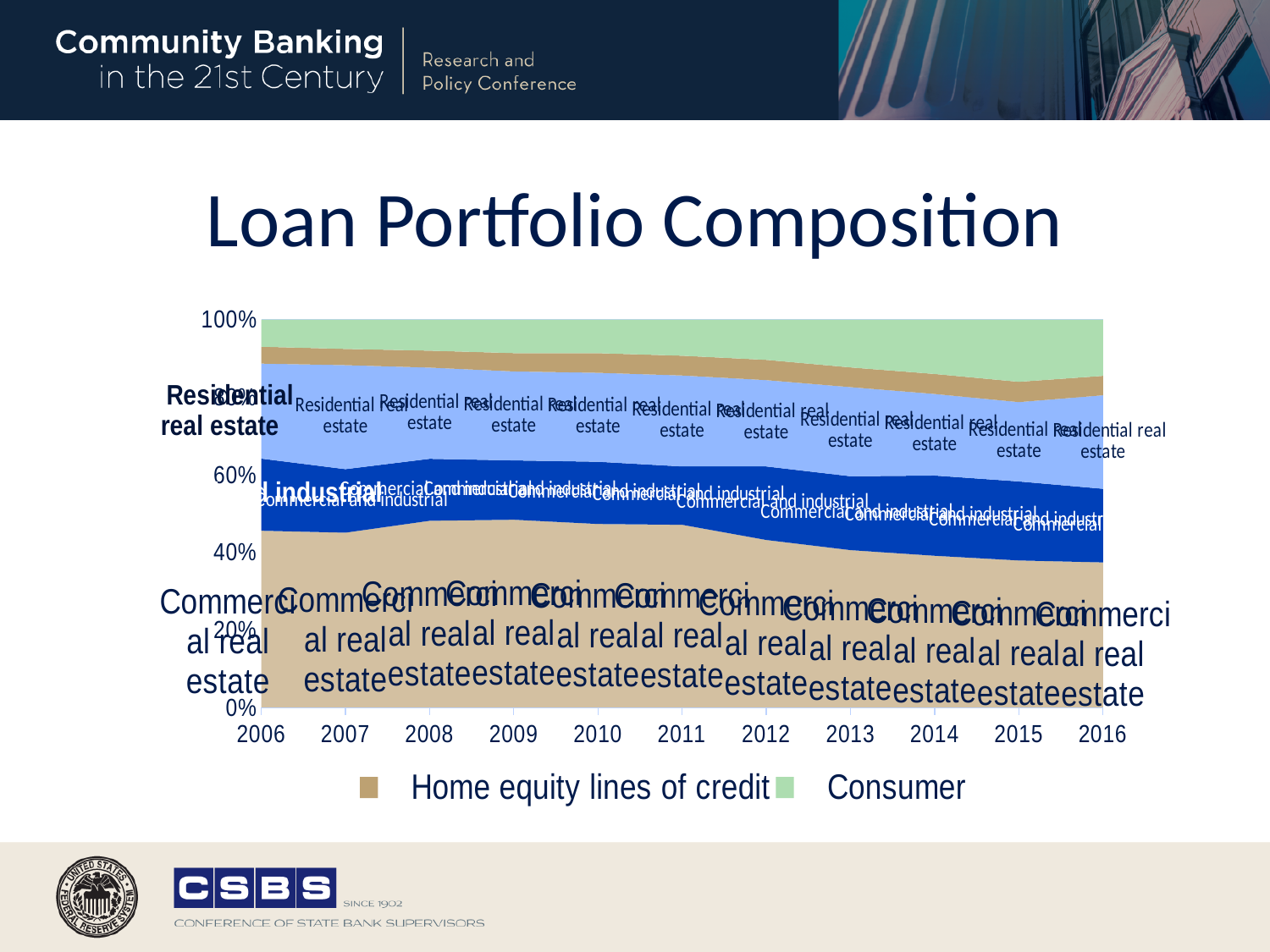
Does the Commercial real estate share of the portfolio rise or fall from 2006 to 2016? fall Which loan category has the largest share of the portfolio in 2006? Commercial real estate How many years are shown along the x axis of the chart? 11 Which two series are named in the legend at the bottom of the chart? Home equity lines of credit and Consumer Is the Commercial real estate share in 2006 greater or less than 40%? greater Does the Consumer share of the portfolio rise or fall from 2006 to 2016? rise In 2016, which is larger: the Commercial real estate share or the Residential real estate share? Commercial real estate What kind of chart is shown on the slide? Stacked area chart What is the maximum value shown on the y axis of the chart? 100% What is the title of the chart on the slide? Loan Portfolio Composition Is the Consumer share in 2016 greater or less than 20%? less